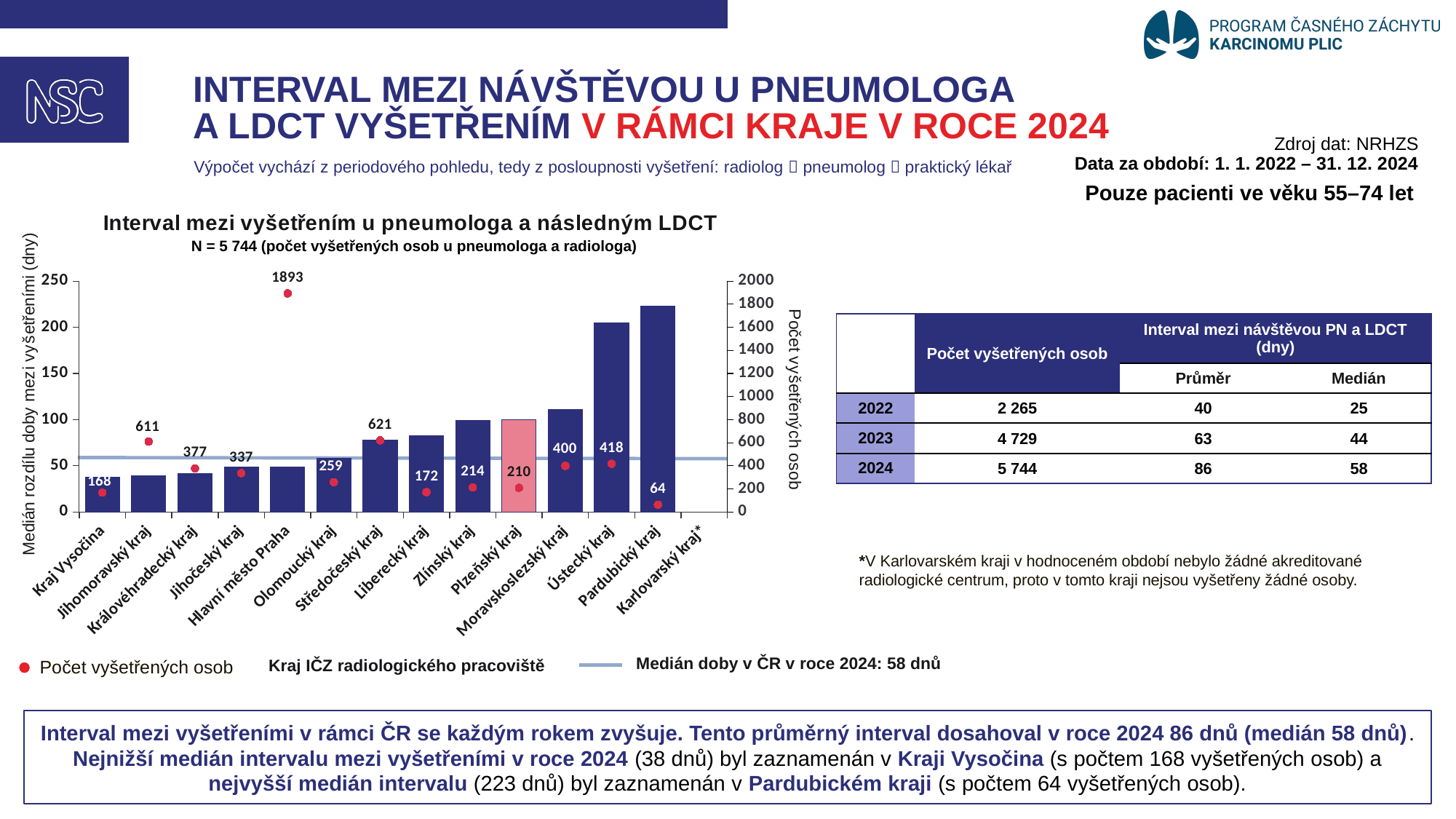
Which region has the highest number of examined persons (red dot)? Hlavní město Praha How many examined persons (Počet vyšetřených osob) are shown for Středočeský kraj? 621 Is the median interval bar for Liberecký kraj greater or less than 100 days? less What kind of chart is used to show the median interval by region? bar chart Which has more examined persons, Jihomoravský kraj or Královéhradecký kraj? Jihomoravský kraj Is the median interval bar for Ústecký kraj greater or less than 150 days? greater Which region with a plotted value has the lowest number of examined persons? Pardubický kraj What is the difference in the number of examined persons between Olomoucký kraj and Zlínský kraj? 45 What is the difference in the number of examined persons between Ústecký kraj and Moravskoslezský kraj? 18 What is the number of examined persons for Kraj Vysočina? 168 How many regions are listed on the x axis of the chart? 14 Which region's bar is highlighted in pink instead of dark blue? Plzeňský kraj